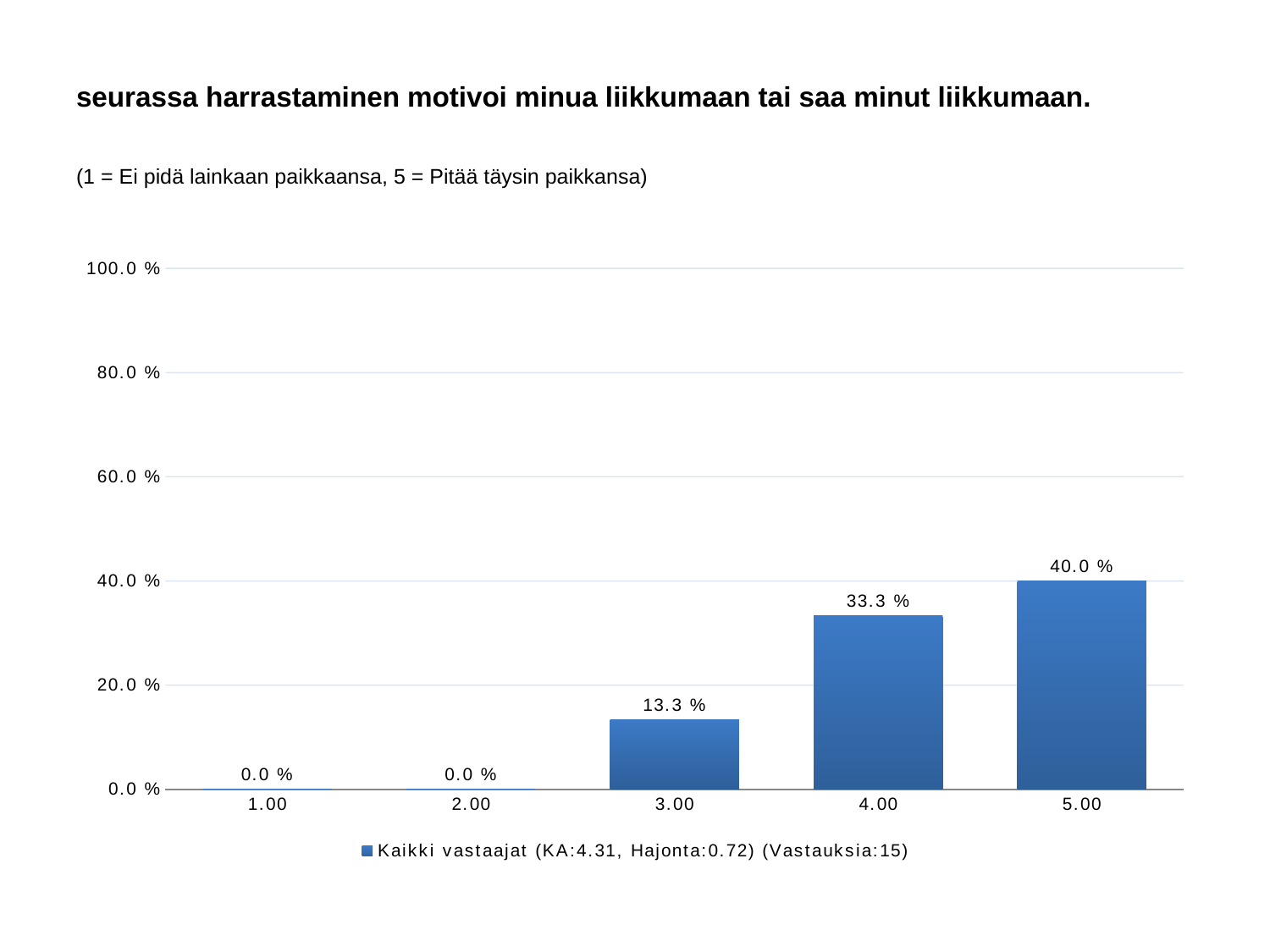
What is the value for category 4.00? 33.3 % How many categories are shown on the x axis? 5 What is the legend entry for the series shown? Kaikki vastaajat (KA:4.31, Hajonta:0.72) (Vastauksia:15) What is the value for category 1.00? 0.0 % What is the value for category 5.00? 40.0 % Is the value for 5.00 greater or less than 20.0 %? greater What is the value for category 3.00? 13.3 % What is the difference between the values for 5.00 and 4.00? 6.7 % Which is larger, the value for 3.00 or the value for 4.00? 4.00 What is the difference between the values for 4.00 and 3.00? 20.0 % Which category has the highest value? 5.00 What kind of chart is shown on the slide? bar chart